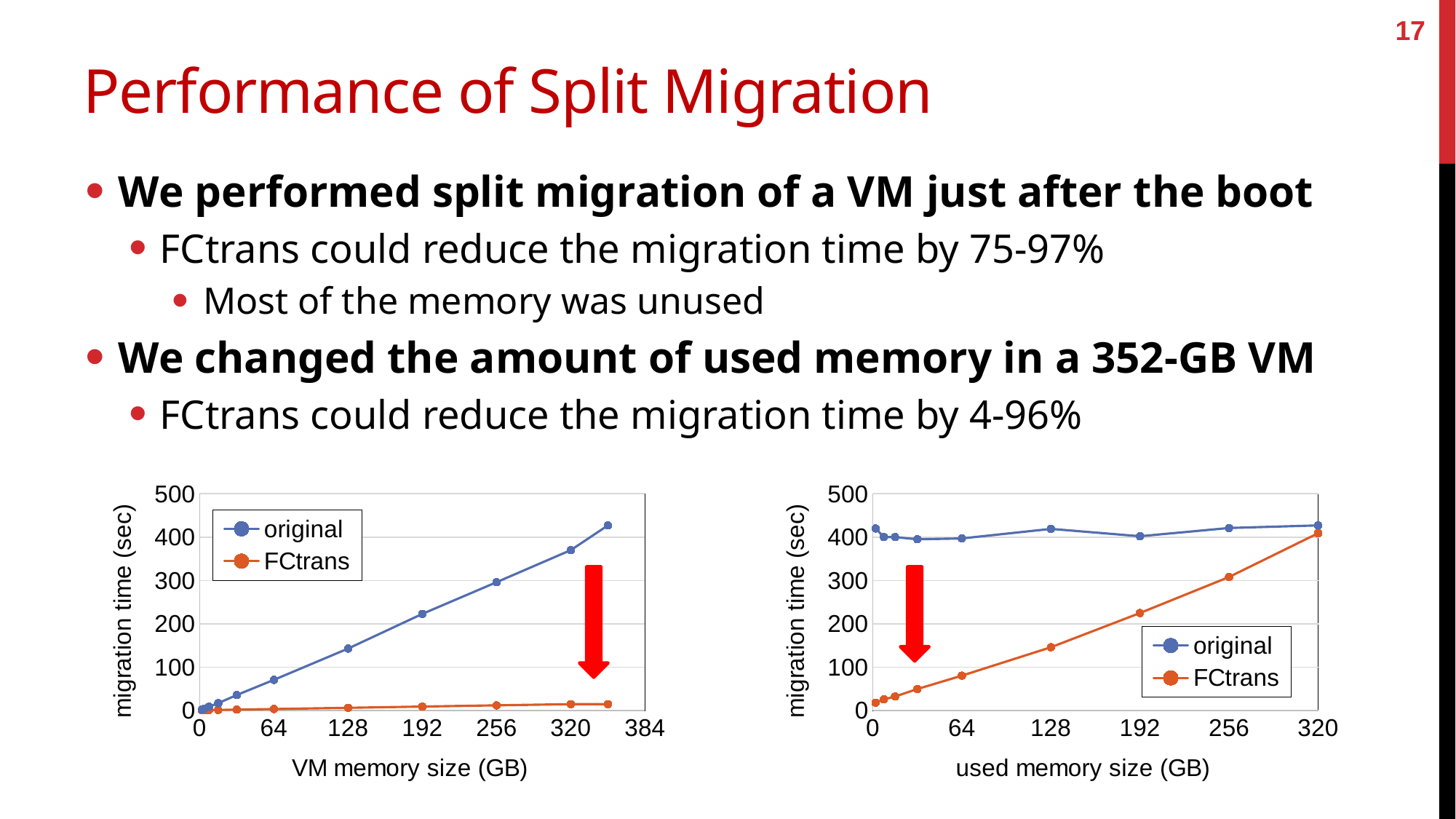
What kind of chart is the left chart (VM memory size)? line chart How many series does the legend of the right chart (used memory size) list? 2 In the right chart (used memory size), is the value for FCtrans at 128 GB greater or less than 100? greater In the left chart (VM memory size), which series has the larger value at 320 GB, original or FCtrans? original What is the x-axis title of the right chart? used memory size (GB) In the right chart (used memory size), is the value for FCtrans at 64 GB greater or less than 100? less In the left chart (VM memory size), is the value for original at 352 GB greater or less than 400? greater In the right chart (used memory size), which series has the larger value at 64 GB, original or FCtrans? original In the left chart (VM memory size), does the original series rise or fall as VM memory size increases? rise